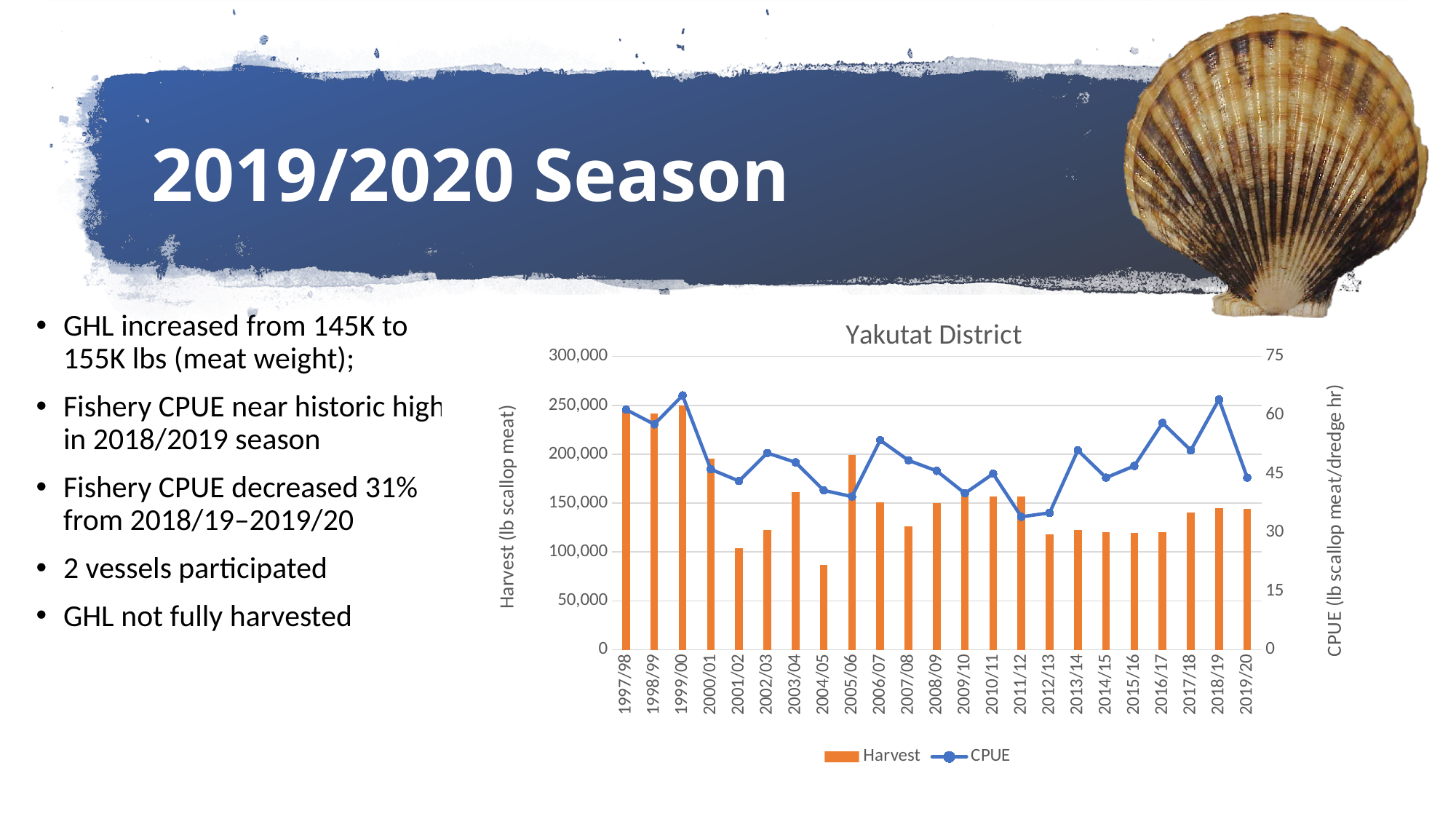
Which season has the lowest Harvest bar? 2004/05 Is the CPUE value for 2018/19 greater or less than 60? greater How many seasons are shown on the x axis of the chart? 23 Does the CPUE line rise or fall from 2018/19 to 2019/20? fall Is the Harvest value for 1999/00 greater or less than 200,000? greater Which series is plotted as a line with markers? CPUE What is the title of the chart? Yakutat District How many series does the chart legend list? 2 Is the CPUE value for 2011/12 greater or less than 45? less What kind of chart is shown on the slide? Combined bar and line chart Which season has the larger Harvest value, 2000/01 or 2001/02? 2000/01